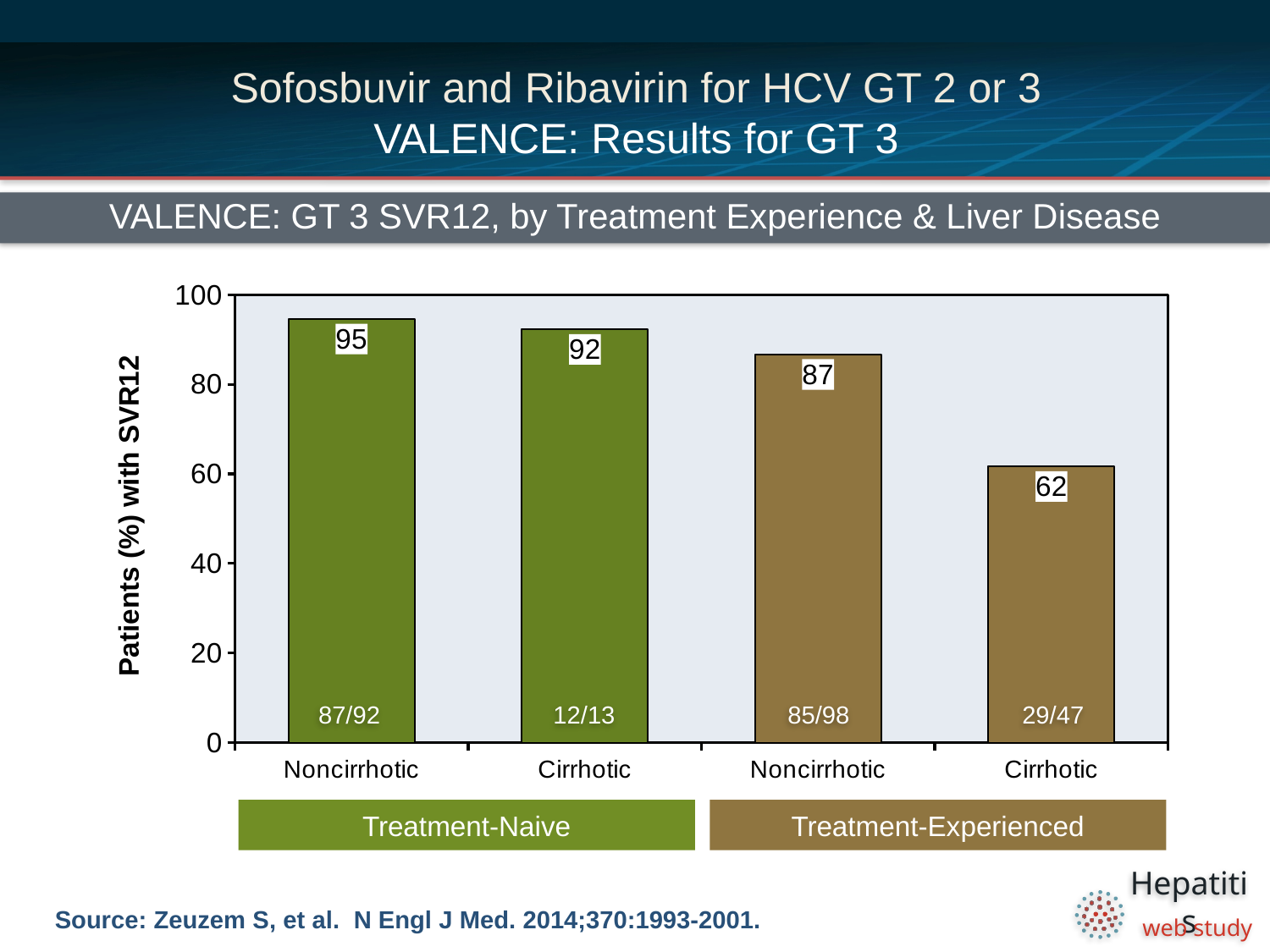
Is the SVR12 rate for Treatment-Experienced Cirrhotic patients greater or less than 80? less What is the SVR12 rate for Treatment-Experienced Cirrhotic patients? 62 Which has a higher SVR12 rate: Treatment-Naive Cirrhotic or Treatment-Experienced Noncirrhotic? Treatment-Naive Cirrhotic What is the SVR12 rate for Treatment-Naive Noncirrhotic patients? 95 What is the difference in SVR12 rate between Treatment-Experienced Noncirrhotic and Treatment-Experienced Cirrhotic patients? 25 What is the SVR12 rate for Treatment-Naive Cirrhotic patients? 92 How many bars are shown in the chart? 4 What is the label of the y-axis? Patients (%) with SVR12 What kind of chart is shown on the slide? Bar chart What fraction of patients is shown inside the Treatment-Experienced Noncirrhotic bar? 85/98 Which group has the lowest SVR12 rate? Treatment-Experienced Cirrhotic Which group has the highest SVR12 rate? Treatment-Naive Noncirrhotic